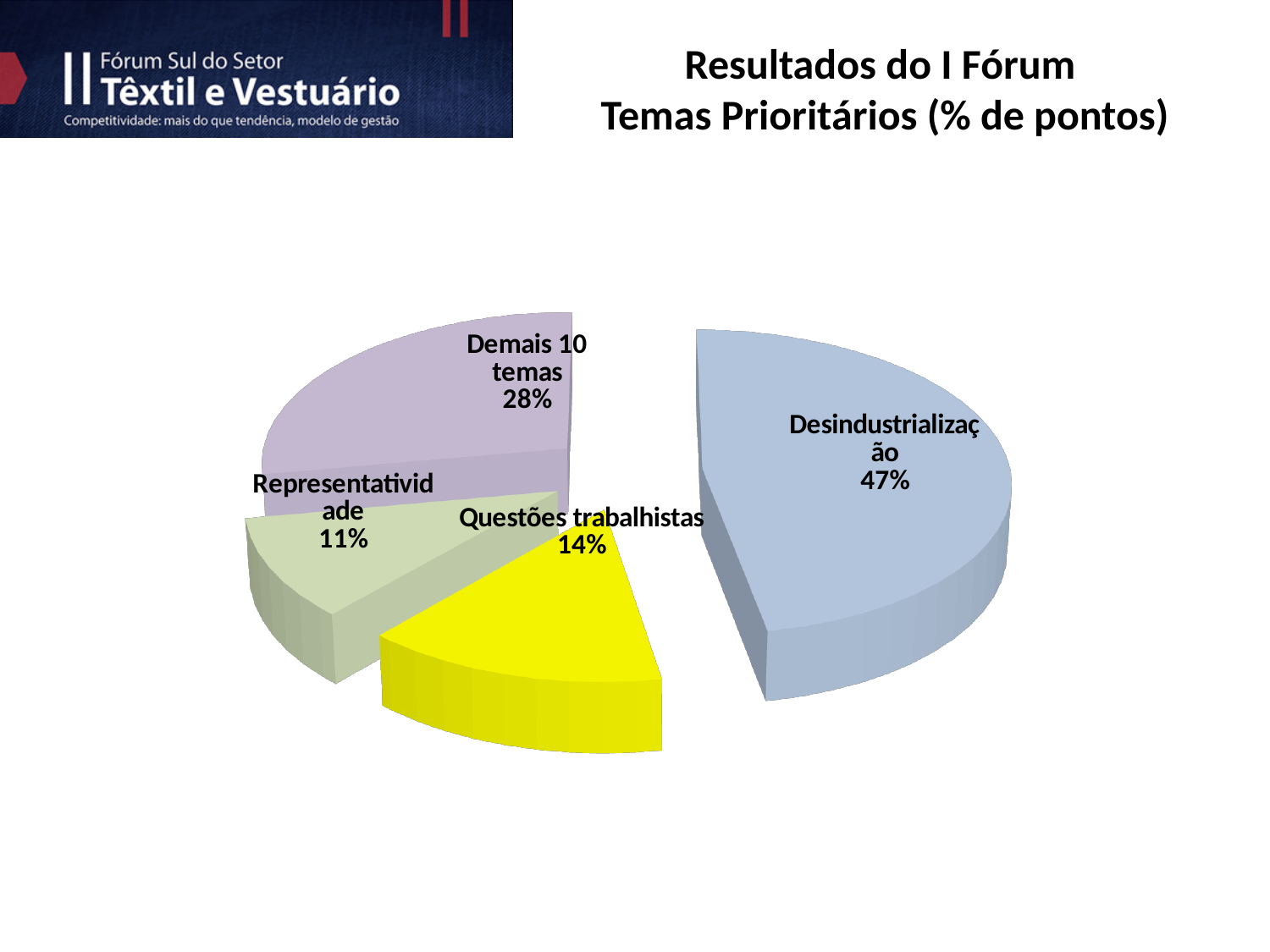
What is the title of the chart on the slide? Resultados do I Fórum Temas Prioritários (% de pontos) What is the difference in percentage points between Desindustrialização and Demais 10 temas? 19 What share of the pie does Representatividade have? 11% How many categories are shown in the pie chart? 4 What share of the pie does Questões trabalhistas have? 14% Which category has the largest slice of the pie? Desindustrialização What kind of chart is shown on the slide? Pie chart What share of the pie does Desindustrialização have? 47% Which category has the smallest slice of the pie? Representatividade What is the difference in percentage points between Questões trabalhistas and Representatividade? 3 Which is larger, the share for Demais 10 temas or the share for Questões trabalhistas? Demais 10 temas